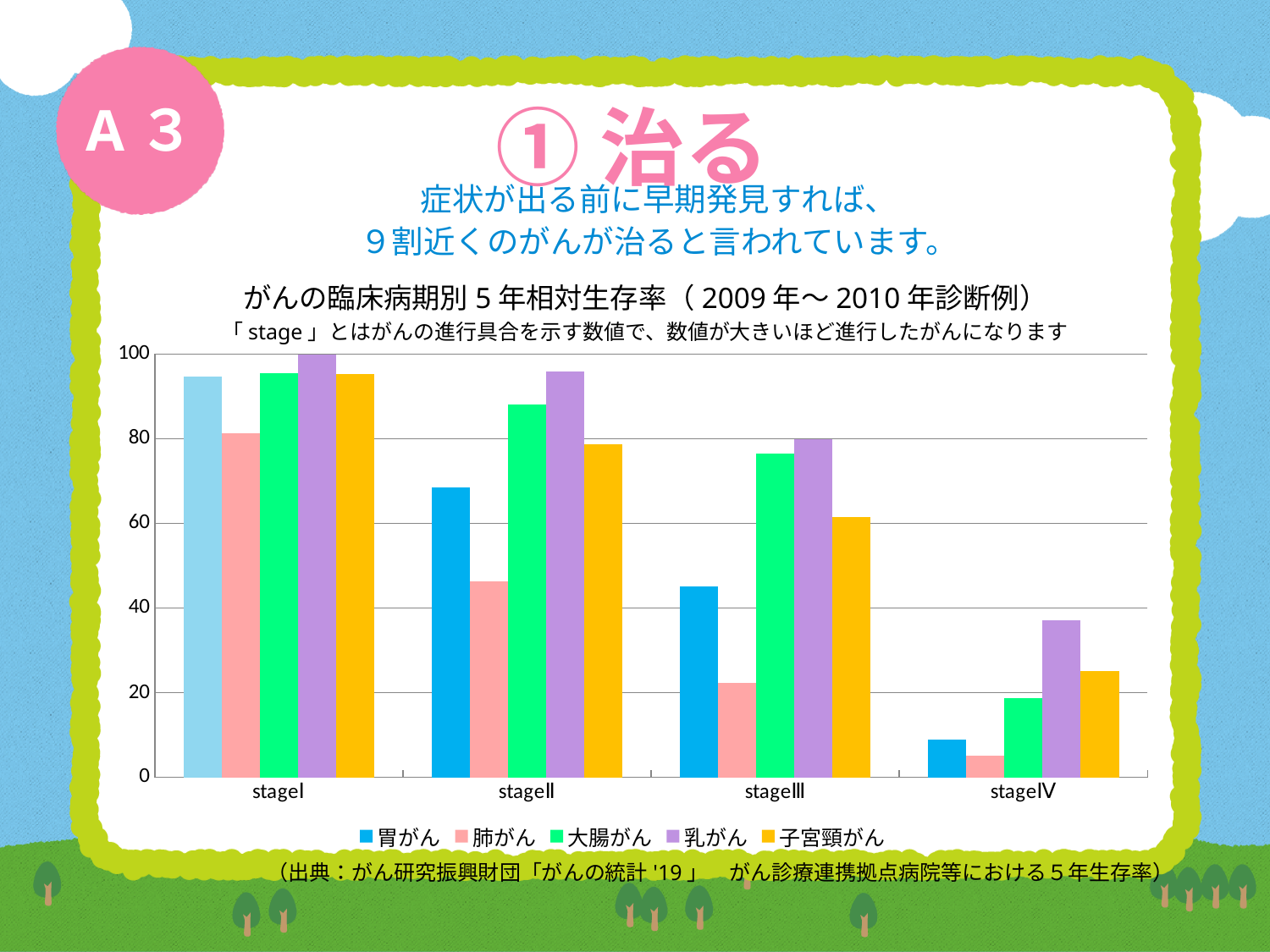
Is the value for 大腸がん at stageⅡ greater or less than 80? greater Do the values for 肺がん rise or fall from stageⅠ to stageⅣ? fall How many series does the legend list? 5 At stageⅢ, which is larger: the value for 大腸がん or for 子宮頸がん? 大腸がん Is the value for 肺がん at stageⅢ greater or less than 40? less Is the value for 胃がん at stageⅡ greater or less than 60? greater At stageⅣ, which cancer type has the highest survival rate? 乳がん At stageⅡ, which cancer type has the lowest survival rate? 肺がん What kind of chart is shown on the slide? bar chart At stageⅣ, which cancer type has the lowest survival rate? 肺がん How many stage categories are shown on the x axis? 4